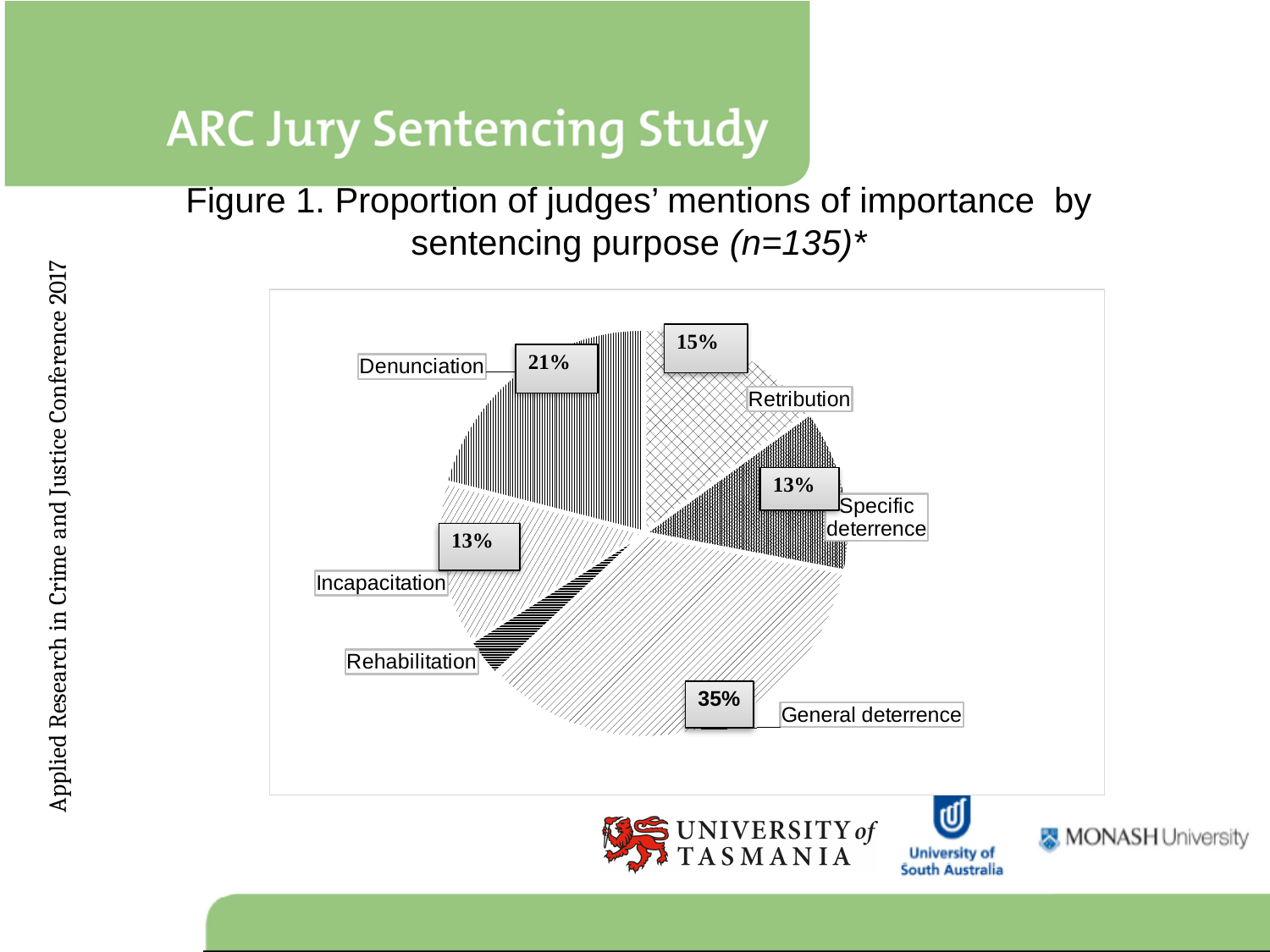
How many sentencing purposes (slices) are shown in the pie chart? 6 What share of judges' mentions does General deterrence account for? 35% What is the difference in percentage points between General deterrence and Denunciation? 14 percentage points What is the value shown for Retribution? 15% Which sentencing purpose has the smallest slice of the pie? Rehabilitation What is the value shown for Incapacitation? 13% What kind of chart is shown on the slide? pie chart Which is larger, the share for Denunciation or the share for Retribution? Denunciation What is the value shown for Specific deterrence? 13% Which sentencing purpose has the largest share of the pie? General deterrence What sample size (n) is given in the figure title? n=135 What is the value shown for Denunciation? 21%